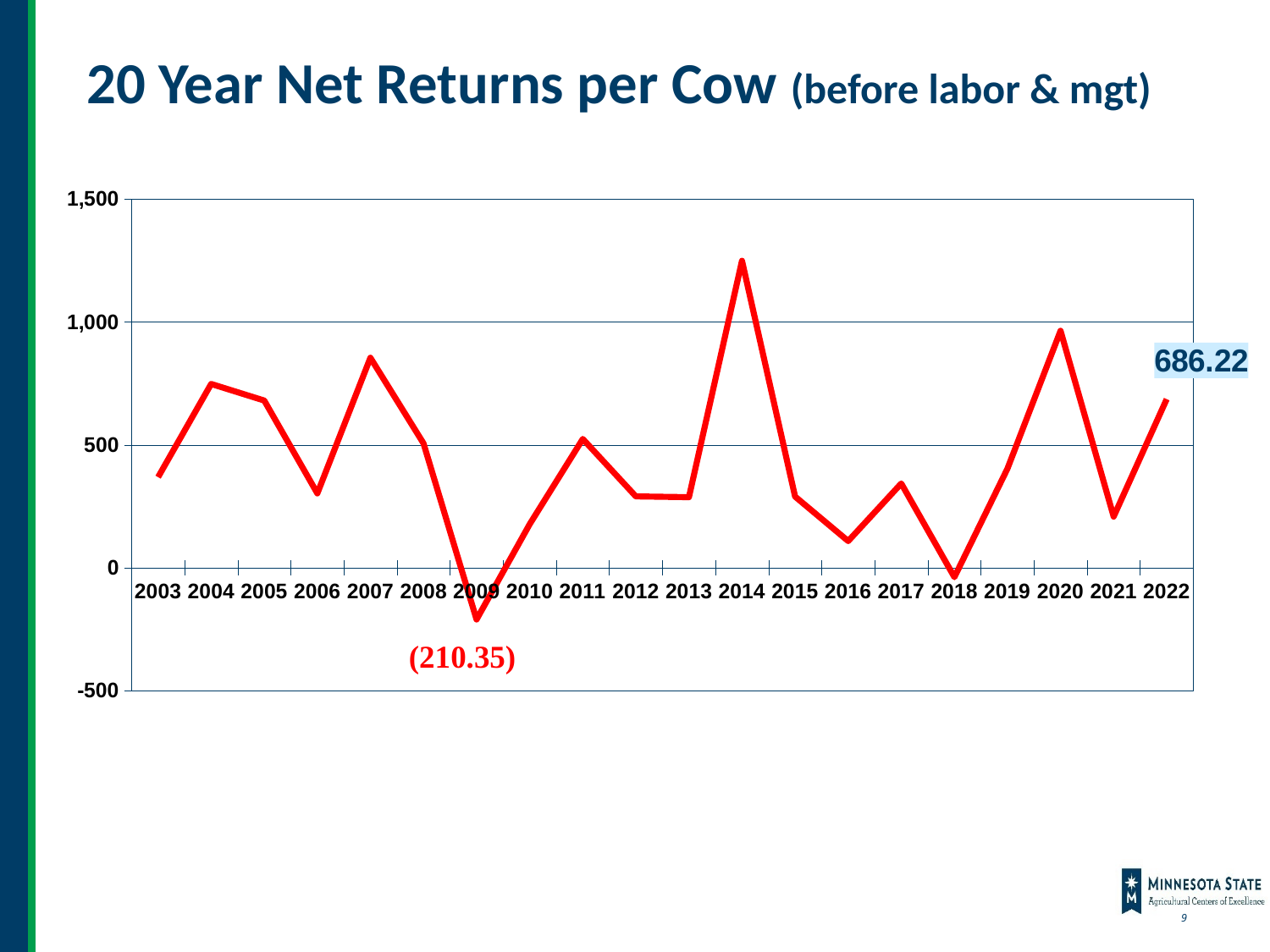
How many years are plotted on the chart? 20 Do the values rise or fall from 2018 to 2020? rise Which year has the larger net return per cow, 2014 or 2020? 2014 Is the value for 2016 greater or less than 500? less Is the value for 2014 greater or less than 1,000? greater What is the title of the chart? 20 Year Net Returns per Cow (before labor & mgt) What is the net return per cow for 2009? (210.35) Which year has the lowest net return per cow? 2009 What type of chart is shown on the slide? line chart What is the net return per cow for 2022? 686.22 Is the value for 2007 greater or less than 500? greater Which year has the highest net return per cow? 2014